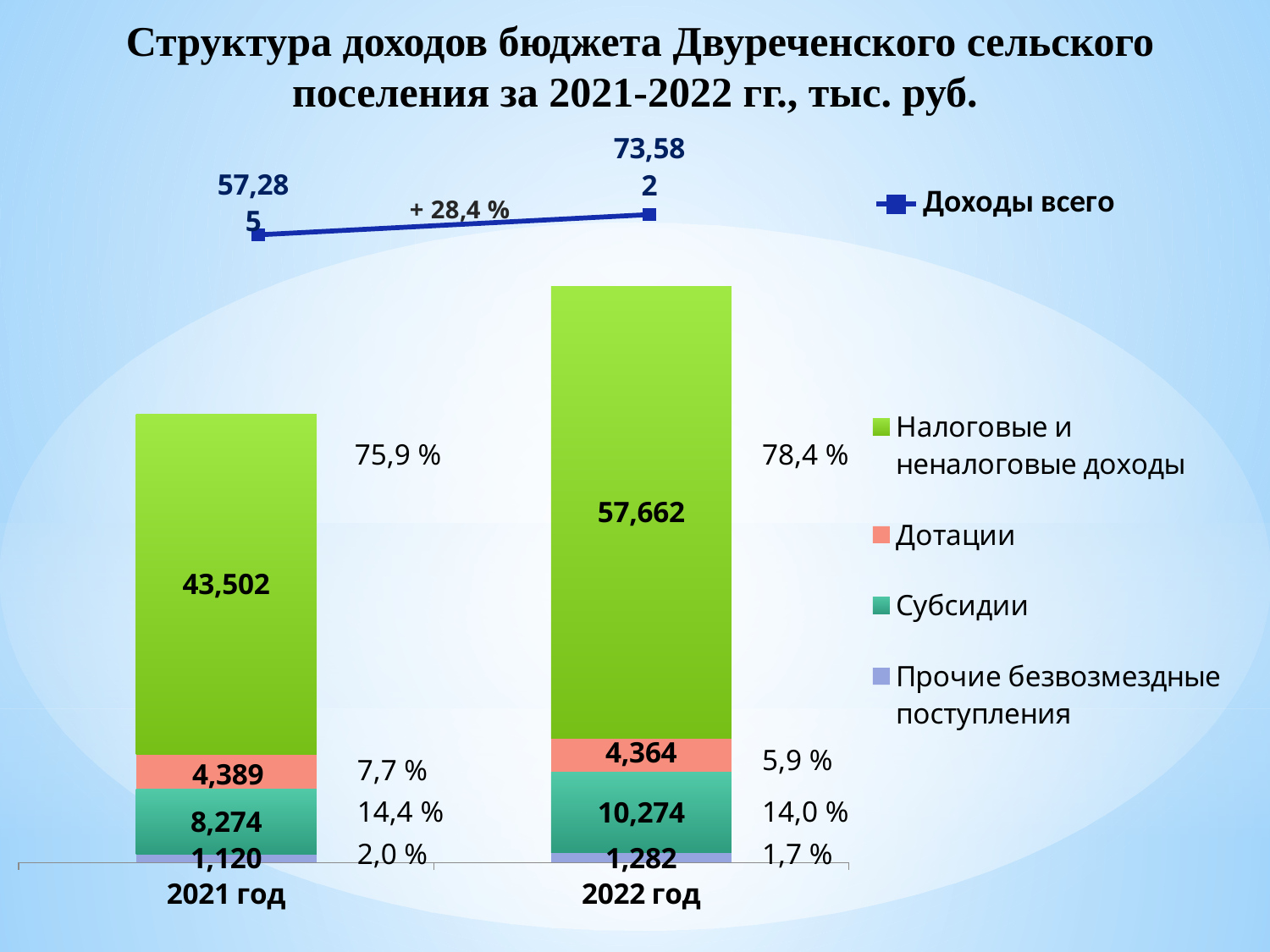
How many series does the legend list? 5 What is the value for Налоговые и неналоговые доходы in 2021 год? 43,502 What is the value for Субсидии in 2022 год? 10,274 What percentage change in Доходы всего is shown between 2021 год and 2022 год? + 28,4 % Which category has the lowest value in 2022 год? Прочие безвозмездные поступления Which is larger: Дотации in 2021 год or Дотации in 2022 год? Дотации in 2021 год What is the value for Прочие безвозмездные поступления in 2022 год? 1,282 What kind of chart is shown on the slide? Stacked bar chart with a line What is the value of Доходы всего for 2022 год? 73,582 What is the difference between Субсидии in 2022 год and Субсидии in 2021 год? 2,000 What is the total of the stacked bar for 2021 год? 57,285 What is the value for Дотации in 2021 год? 4,389